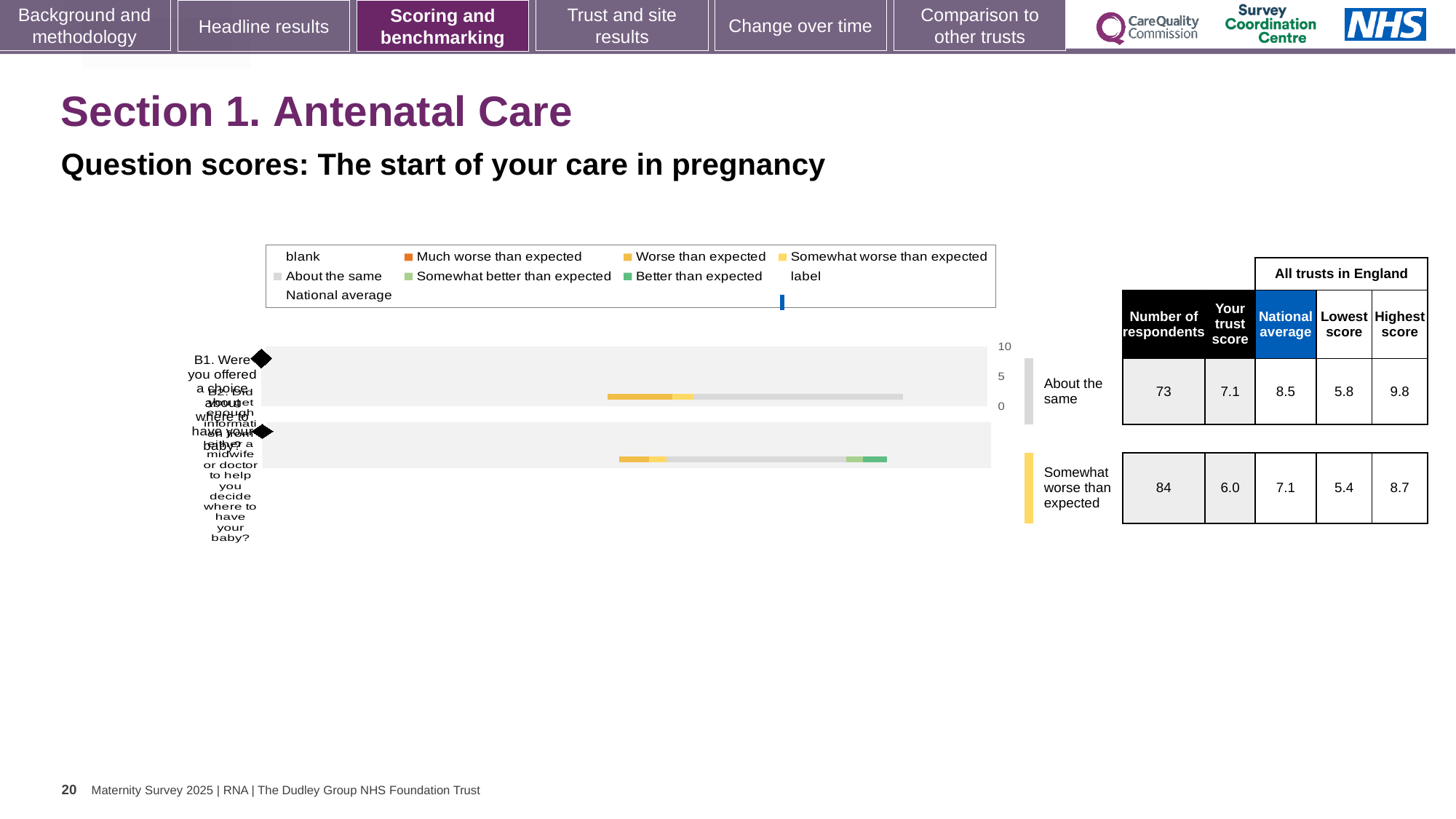
What is the trust score for question B2 in the table next to the chart? 6.0 How many survey questions (categories) are plotted in the chart? 2 What colour does the legend use for 'Somewhat worse than expected'? yellow What is the trust score for question B1 in the table next to the chart? 7.1 Which question has the higher trust score, B1 or B2? B1 How many respondents answered question B2? 84 What is the highest value shown on the chart's score axis? 10 What kind of chart is shown on the slide? bar chart What is the benchmark rating shown for question B1 (Were you offered a choice about where to have your baby?)? About the same What is the benchmark rating shown for question B2 (Did you get enough information from either a midwife or doctor to help you decide where to have your baby?)? Somewhat worse than expected What is the national average for question B1? 8.5 What is the difference between the national average and the trust score for question B1? 1.4